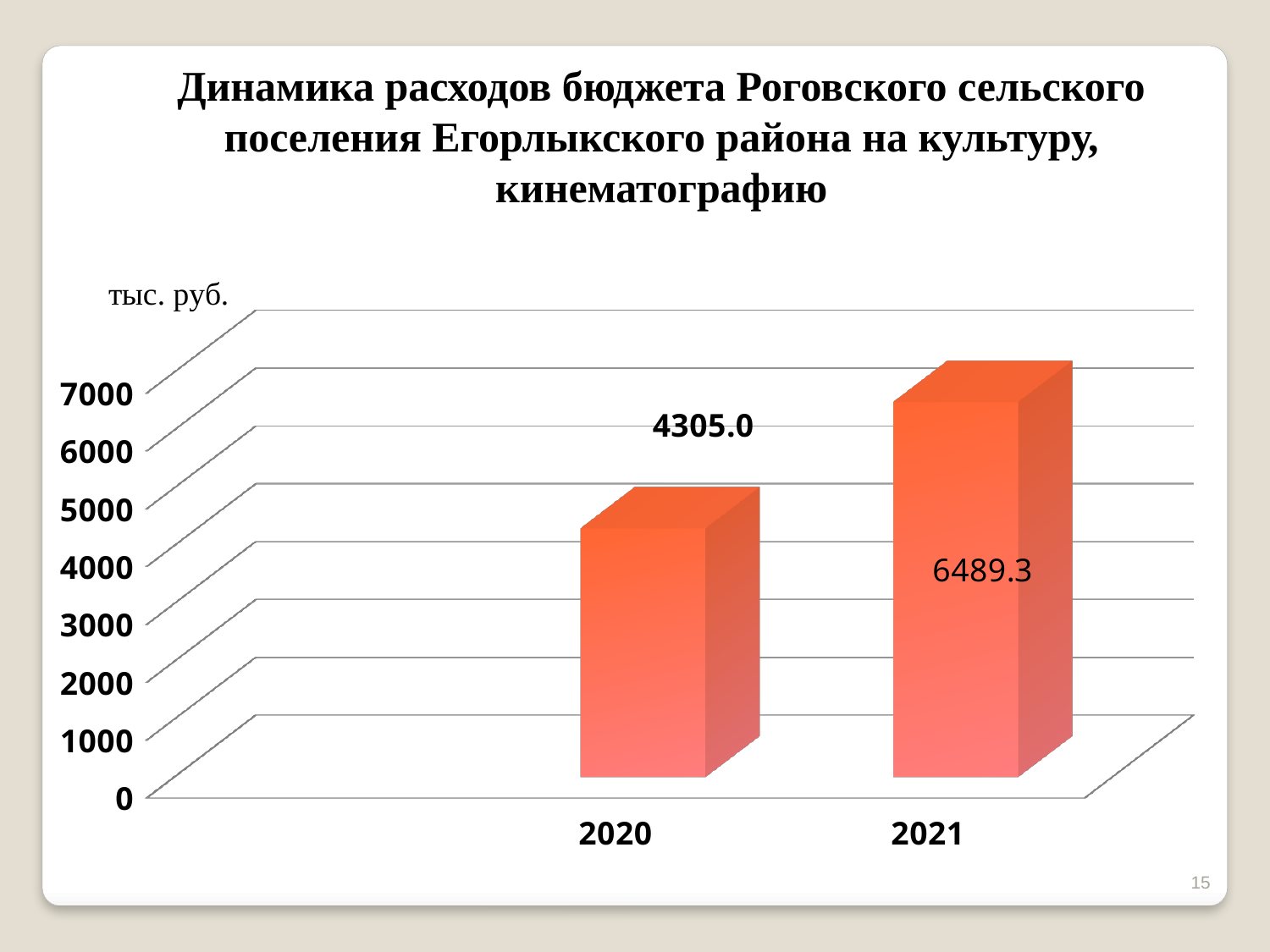
What is the value for 2021? 6489.3 What is the difference between the values for 2021 and 2020? 2184.3 Do the values rise or fall from 2020 to 2021? rise What unit is indicated above the vertical axis? тыс. руб. Which is larger, the value for 2020 or the value for 2021? 2021 What kind of chart is shown on the slide? bar chart Is the value for 2020 greater or less than 5000? less Which year has the highest value? 2021 Which year has the lowest value? 2020 Is the value for 2021 greater or less than 6000? greater How many years are shown on the x axis? 2 What is the value for 2020? 4305.0